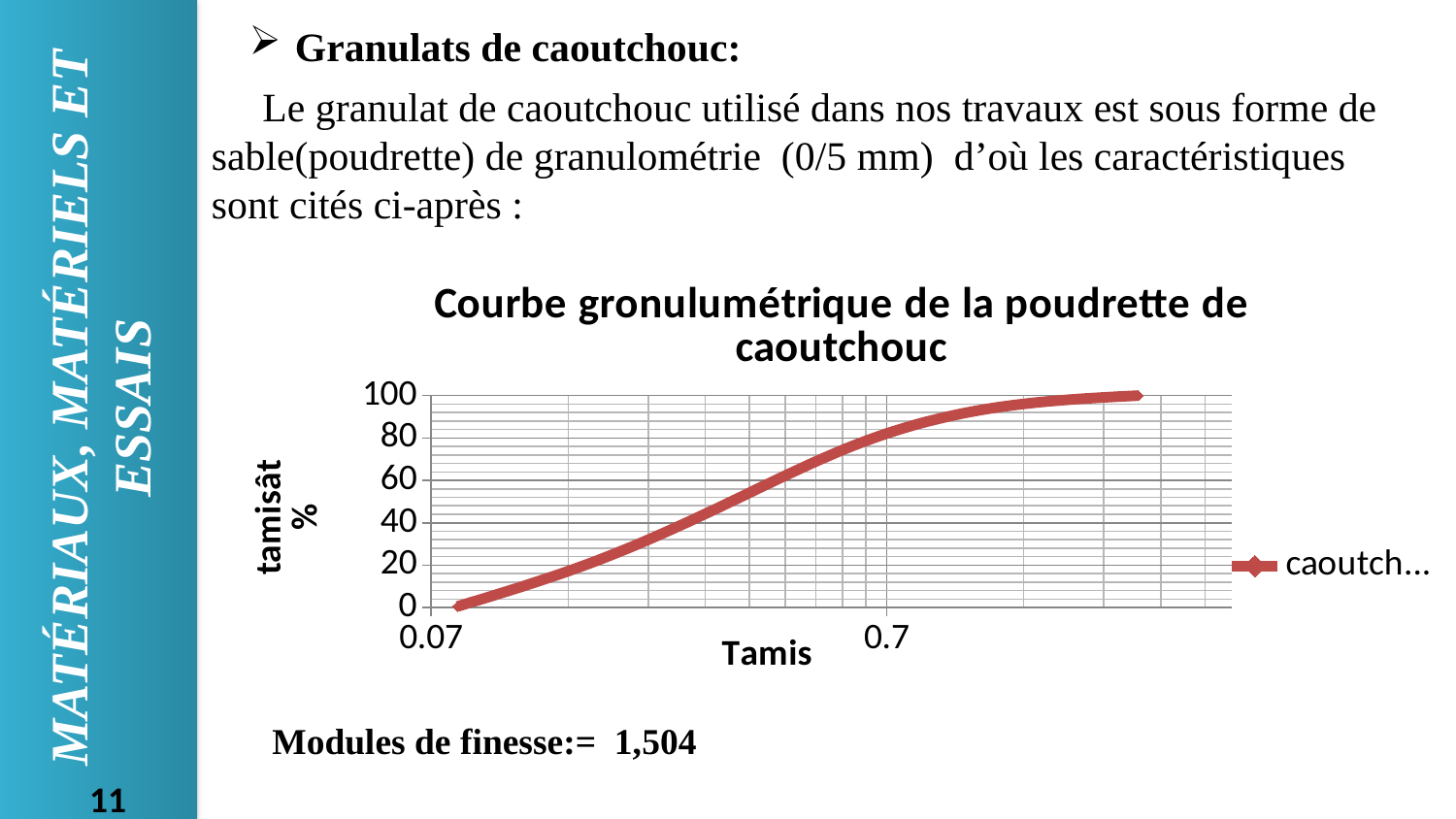
How many series does the chart's legend list? 1 Do the values on the chart rise or fall as Tamis increases along the x axis? rise What is the lowest value the curve reaches on the y axis? 0 What is the highest value the curve reaches on the y axis? 100 Is the value of the curve at Tamis 0.7 greater or less than 60? greater What kind of chart is shown on the slide? line chart What is the title of the chart? Courbe gronulumétrique de la poudrette de caoutchouc Is the value of the curve at Tamis 0.7 greater or less than 40? greater Is the value of the curve at Tamis 0.7 greater or less than 100? less What is the label of the chart's y axis? tamisât %